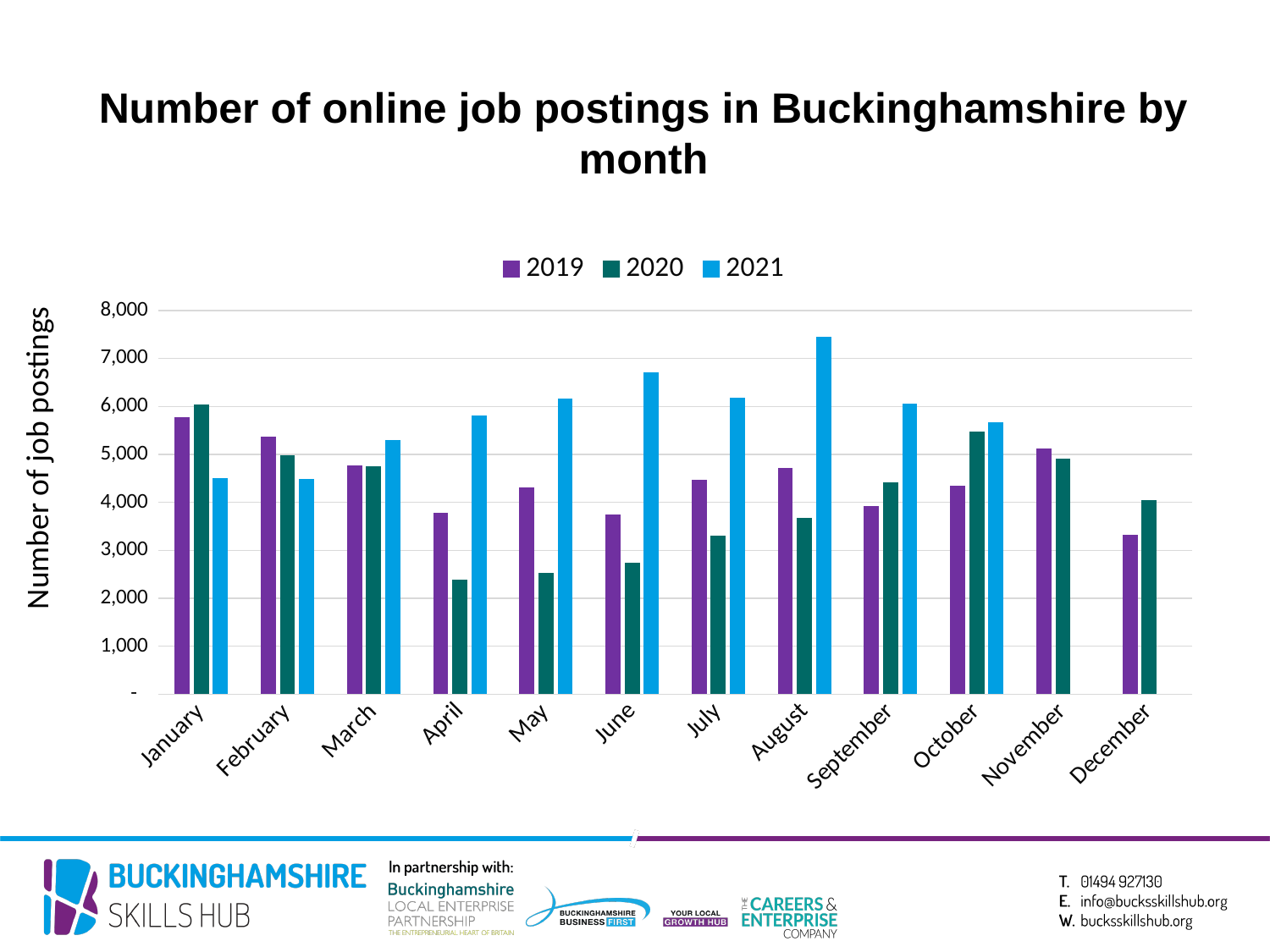
In which month is the 2021 value highest? August In which month is the 2019 value lowest? December How many months are shown on the x axis? 12 In which month is the 2019 value highest? January What kind of chart is shown on the slide? Bar chart Do the 2020 values rise or fall from January to April? fall Which months have no 2021 bar? November and December Is the 2020 value for April greater or less than 3,000? less In June, which series has the larger value, 2019 or 2021? 2021 Is the 2019 value for February greater or less than 5,000? greater Is the 2021 value for August greater or less than 7,000? greater How many series does the legend list? 3